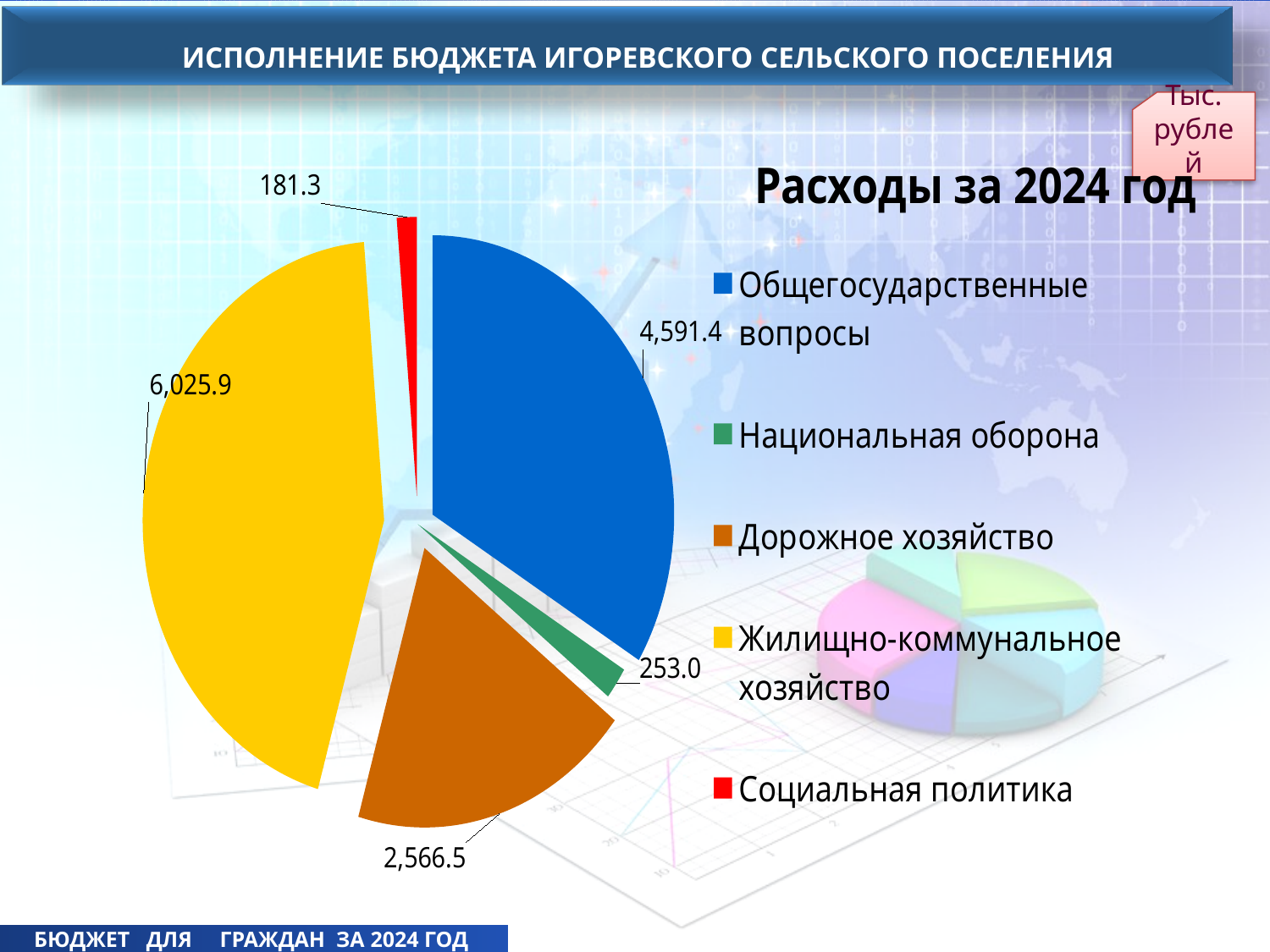
Which is larger: Национальная оборона or Социальная политика? Национальная оборона What is the value for Общегосударственные вопросы? 4,591.4 What is the value for Дорожное хозяйство? 2,566.5 What is the value for Социальная политика? 181.3 What is the difference between Жилищно-коммунальное хозяйство and Общегосударственные вопросы? 1,434.5 Which category has the largest slice of the pie? Жилищно-коммунальное хозяйство What colour is the slice for Дорожное хозяйство? Brown How many categories does the legend of the pie chart list? 5 What type of chart is shown on the slide? Pie chart What is the title of the chart? Расходы за 2024 год What is the value for Жилищно-коммунальное хозяйство? 6,025.9 Which category has the smallest slice of the pie? Социальная политика